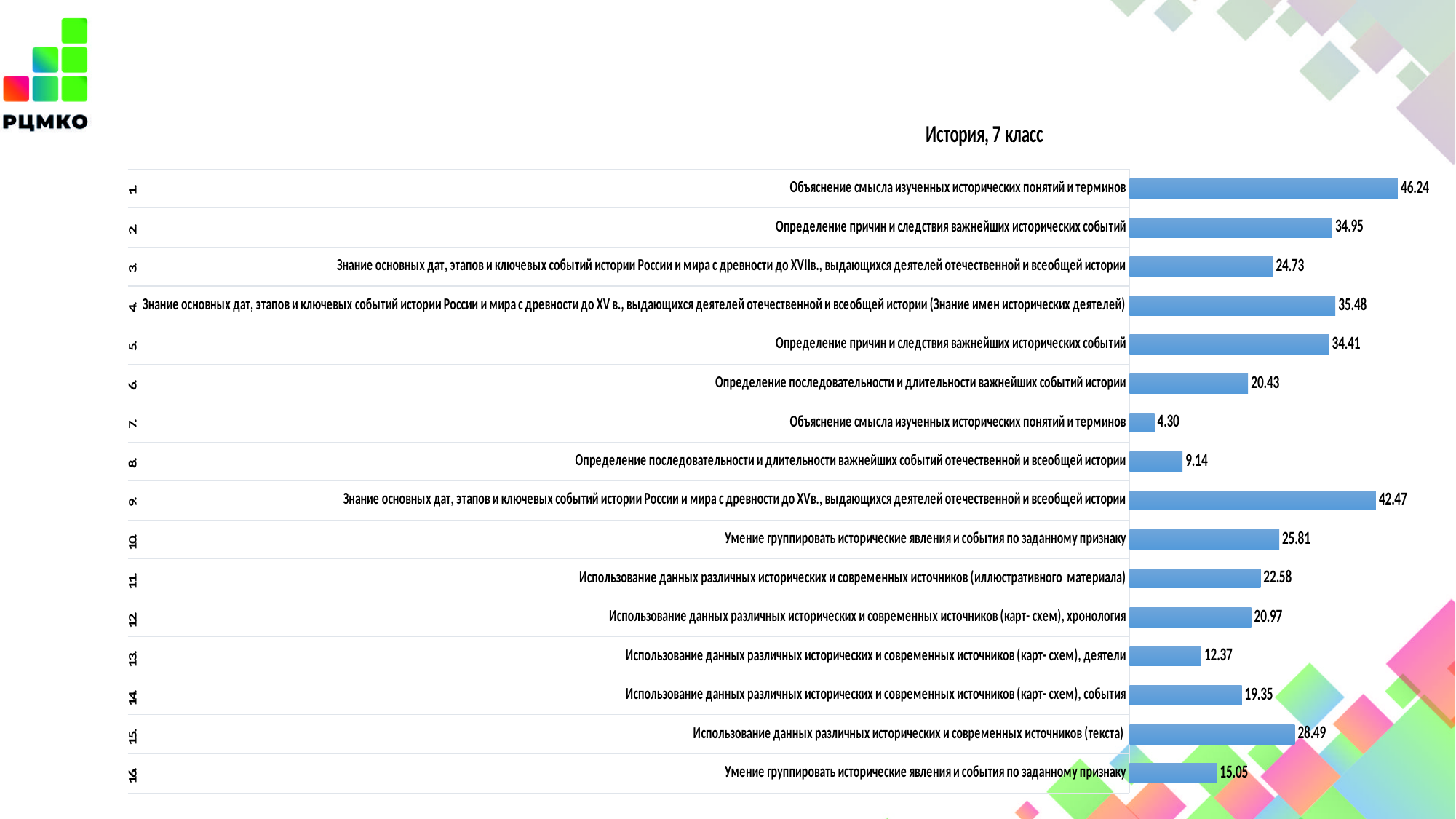
What is the difference between the value for item 4 and the value for item 5? 1.07 What is the title of the chart? История, 7 класс What is the value for item 13 (Использование данных различных исторических и современных источников (карт- схем), деятели)? 12.37 How many categories (bars) are shown in the chart? 16 What is the difference between the value for item 1 and the value for item 7? 41.94 What is the value for item 9 (Знание основных дат, этапов и ключевых событий истории России и мира с древности до XVв.)? 42.47 What is the value for item 15 (Использование данных различных исторических и современных источников (текста))? 28.49 What is the value for item 1 (Объяснение смысла изученных исторических понятий и терминов)? 46.24 Which numbered item has the highest value? 1 Which has a larger value, item 9 or item 2? item 9 Which numbered item has the lowest value? 7 What kind of chart is shown on the slide? bar chart